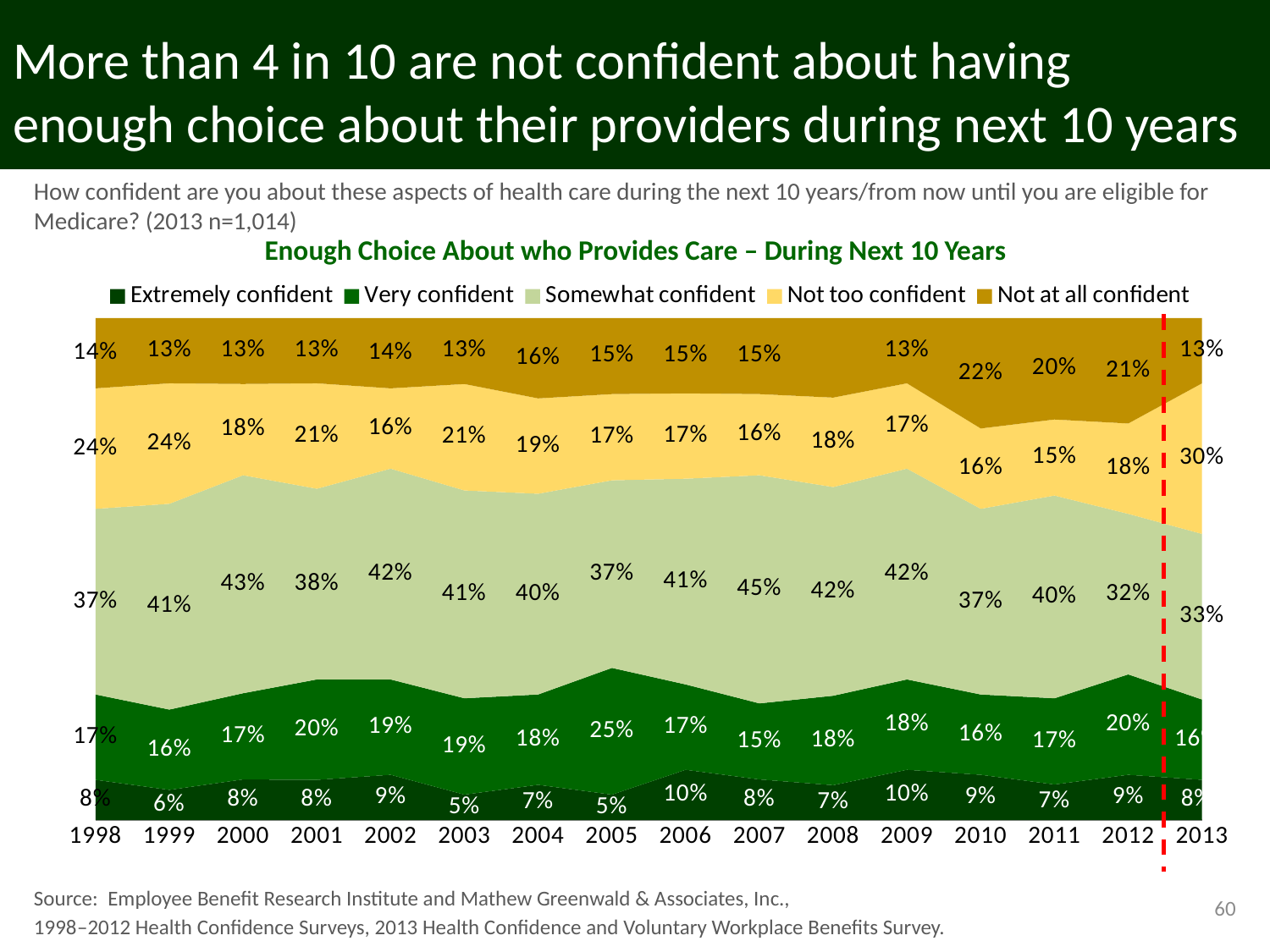
In which year was 'Not at all confident' highest? 2010 What percentage was 'Extremely confident' in 2003? 5% How many series does the legend list? 5 What is the difference in percentage points between 'Not too confident' in 2013 and in 2012? 12 percentage points What is the title of the chart? Enough Choice About who Provides Care – During Next 10 Years What type of chart is shown on the slide? Stacked area chart How many years are shown along the x axis? 16 What percentage was 'Very confident' in 2005? 25% Which is larger: 'Somewhat confident' in 2007 or 'Somewhat confident' in 2012? 2007 What percentage was 'Somewhat confident' in 2007? 45% What percentage was 'Not too confident' in 2013? 30% In which year was 'Not too confident' highest? 2013